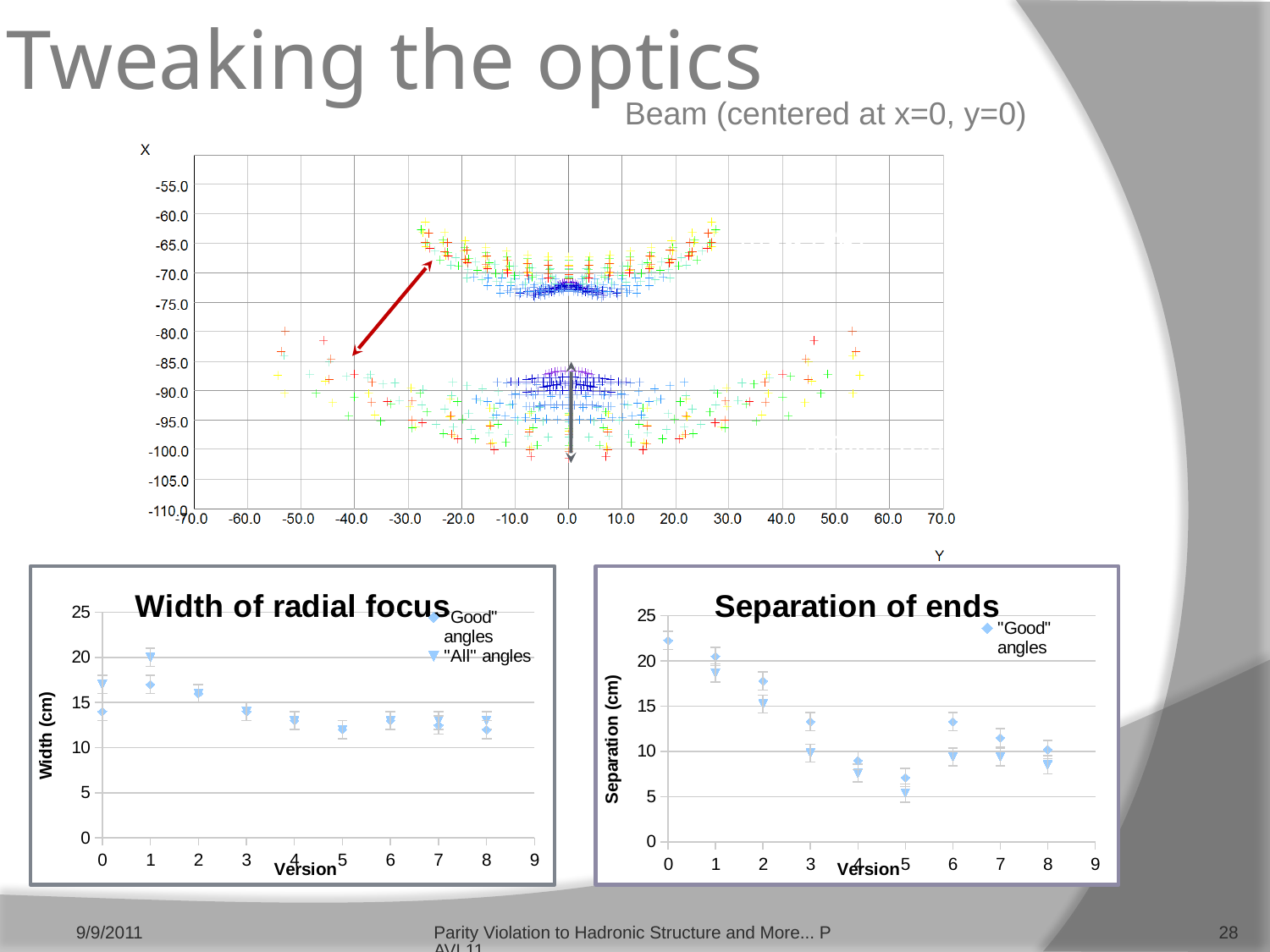
In the "Width of radial focus" chart, is the "All" angles value at version 1 greater or less than 15? greater In the "Separation of ends" chart, is the value at version 5 greater or less than 10? less In the "Separation of ends" chart, at which version is the separation lowest? 5 In the "Width of radial focus" chart, what are the two legend entries? "Good" angles and "All" angles In the "Width of radial focus" chart, how many versions are plotted on the x axis? 9 In the "Separation of ends" chart, which has the larger separation: version 0 or version 4? version 0 What kind of chart is the large chart at the top of the slide? scatter chart In the "Width of radial focus" chart, is the "Good" angles value at version 0 greater or less than 15? less In the "Width of radial focus" chart, do the width values generally rise or fall as the version number increases? fall In the "Width of radial focus" chart, at which version is the "All" angles width highest? 1 In the "Width of radial focus" chart, how many series does the legend list? 2